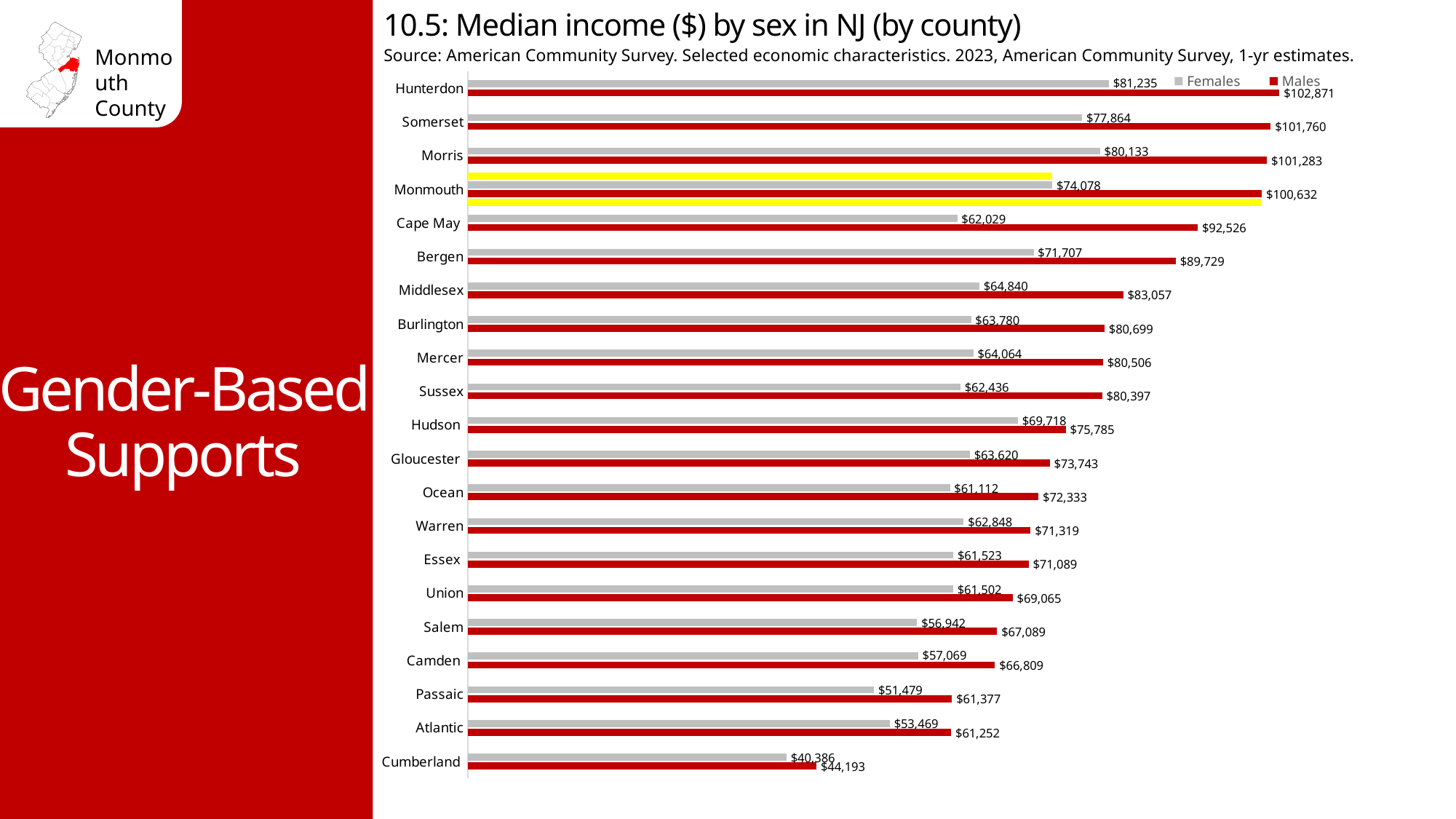
What is the difference between the male and female median incomes in Cumberland County? $3,807 How many series does the legend list? 2 What type of chart is shown on the slide? Bar chart How many counties are shown in the chart? 21 What is the difference between the male and female median incomes in Monmouth County? $26,554 What is the median income for females in Monmouth County? $74,078 Which county's bars are highlighted in yellow on the chart? Monmouth Which county has the lowest median income for females? Cumberland Which county has the highest median income for males? Hunterdon What is the median income for males in Cape May County? $92,526 Which county has a higher female median income, Hunterdon or Morris? Hunterdon What is the median income for males in Monmouth County? $100,632